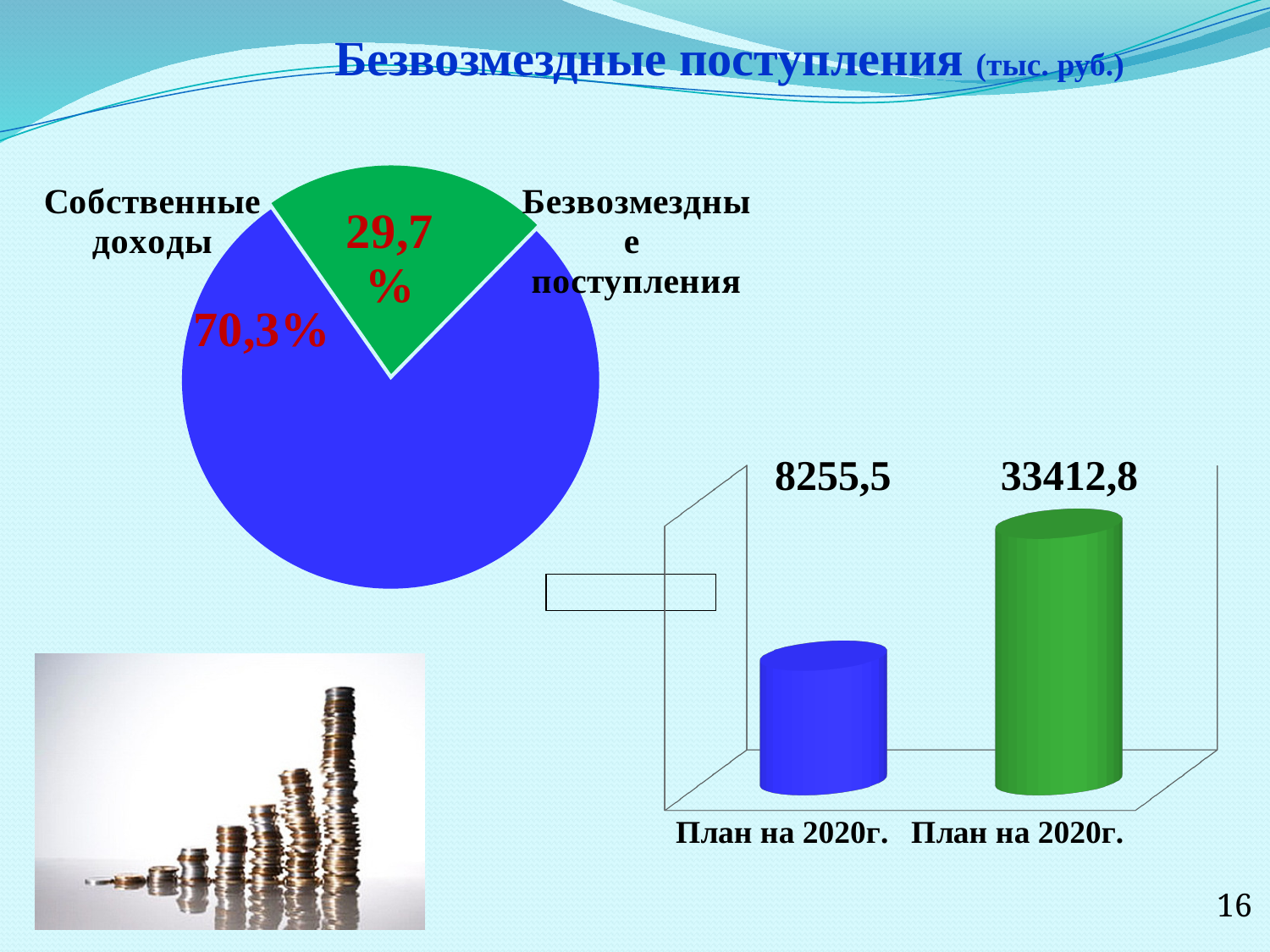
In the pie chart, what is the difference between the share of Собственные доходы and the share of Безвозмездные поступления? 40,6% In the pie chart, which slice is the smallest? Безвозмездные поступления What kind of chart is the chart on the lower right of the slide? bar chart In the pie chart, which slice is the largest? Собственные доходы In the bar chart, what is the value of the left (blue) bar? 8255,5 What kind of chart is the chart on the left of the slide? pie chart How many slices does the pie chart have? 2 In the bar chart, which bar is taller, the blue one or the green one? the green one In the bar chart, what is the value of the right (green) bar? 33412,8 In the bar chart, what is the difference between the green bar and the blue bar? 25157,3 In the pie chart, what share is shown for Безвозмездные поступления? 29,7% In the pie chart, what share is shown for Собственные доходы? 70,3%